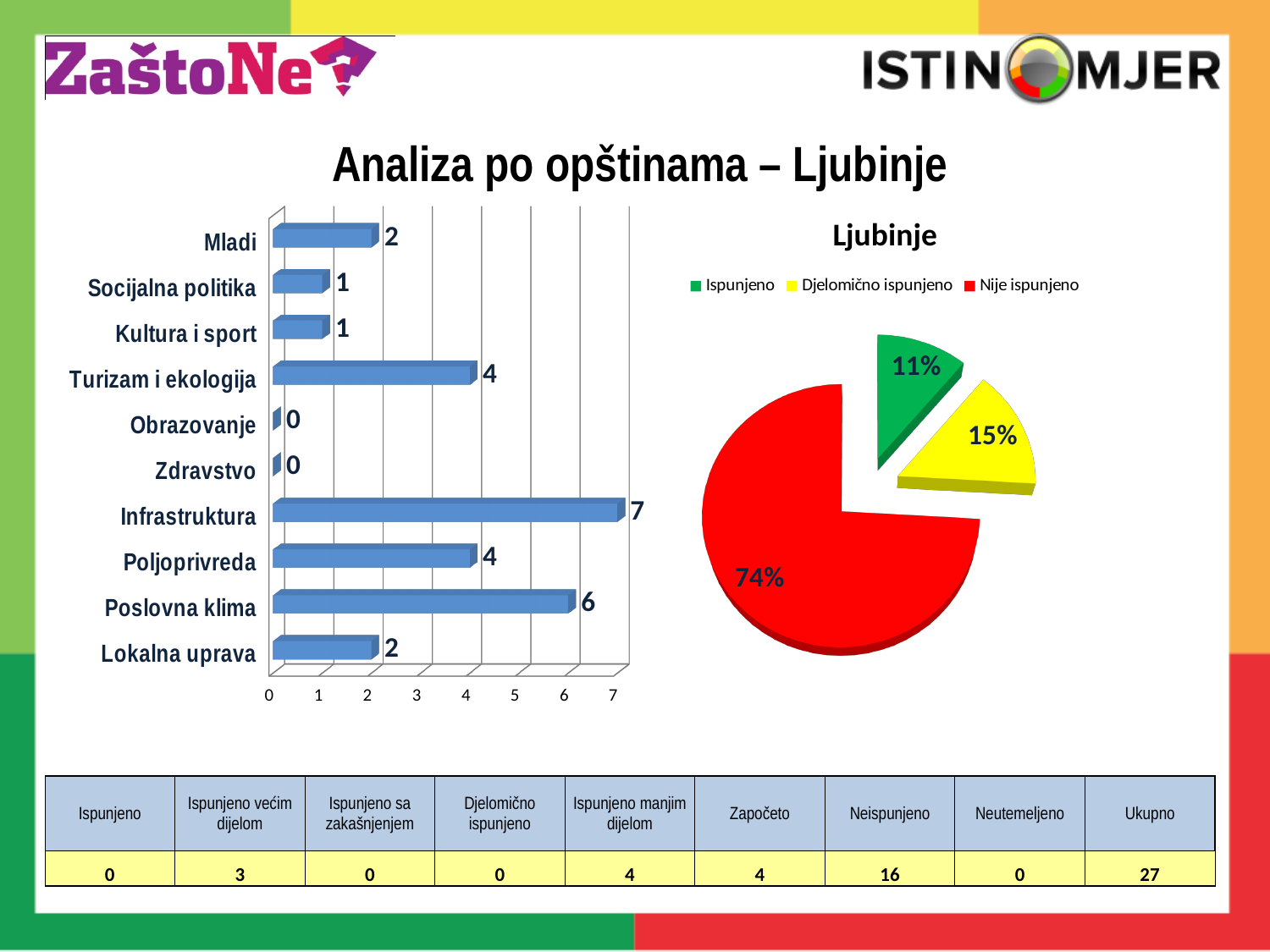
In the bar chart on the left, which category has the highest value? Infrastruktura In the bar chart on the left, how many categories have a value of 0? 2 In the bar chart on the left, what is the difference between Infrastruktura and Turizam i ekologija? 3 In the bar chart on the left, which is larger, Poslovna klima or Poljoprivreda? Poslovna klima In the bar chart on the left, what is the value for Poslovna klima? 6 In the pie chart titled Ljubinje, which slice is the smallest? Ispunjeno How many series does the legend of the pie chart titled Ljubinje list? 3 In the bar chart on the left, what is the value for Infrastruktura? 7 In the pie chart titled Ljubinje, what share is Nije ispunjeno? 74% In the pie chart titled Ljubinje, what share is Ispunjeno? 11% In the bar chart on the left, how many categories are shown? 10 What kind of chart is the chart on the left? Bar chart